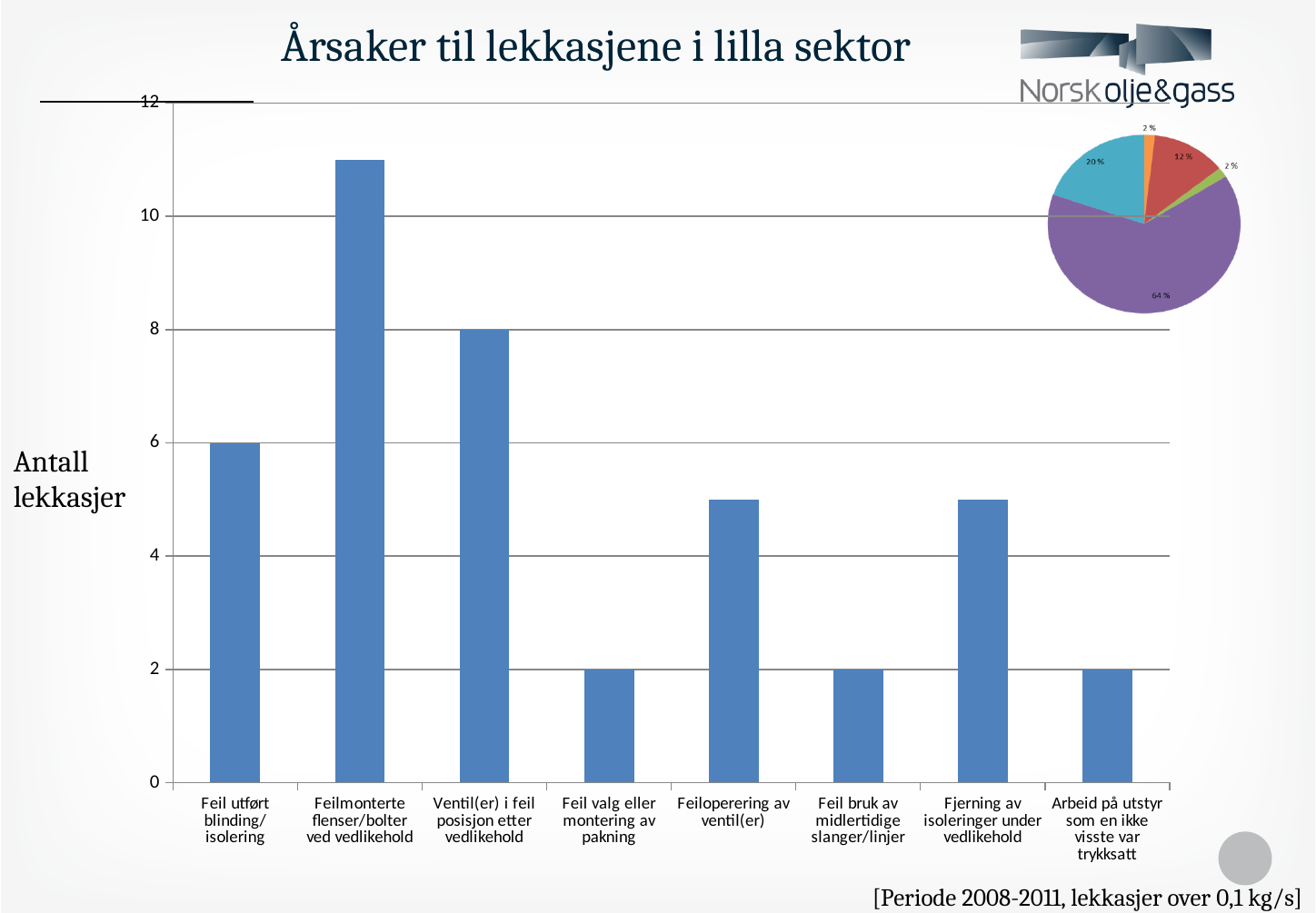
In the bar chart, which category has the highest number of leaks? Feilmonterte flenser/bolter ved vedlikehold In the bar chart, what is the value for 'Feil utført blinding/isolering'? 6 What is the label on the y axis of the bar chart? Antall lekkasjer What type of chart is the main chart on the slide? bar chart In the bar chart, what is the value for 'Ventil(er) i feil posisjon etter vedlikehold'? 8 In the bar chart, is the value for 'Feiloperering av ventil(er)' greater or less than 4? greater In the bar chart, what is the value for 'Feil valg eller montering av pakning'? 2 In the bar chart, is the value for 'Feilmonterte flenser/bolter ved vedlikehold' greater or less than 10? greater In the bar chart, which is larger: 'Feil utført blinding/isolering' or 'Ventil(er) i feil posisjon etter vedlikehold'? Ventil(er) i feil posisjon etter vedlikehold How many categories are shown on the x axis of the bar chart? 8 In the bar chart, what is the difference between 'Ventil(er) i feil posisjon etter vedlikehold' and 'Feil utført blinding/isolering'? 2 What is the title of the slide's chart? Årsaker til lekkasjene i lilla sektor